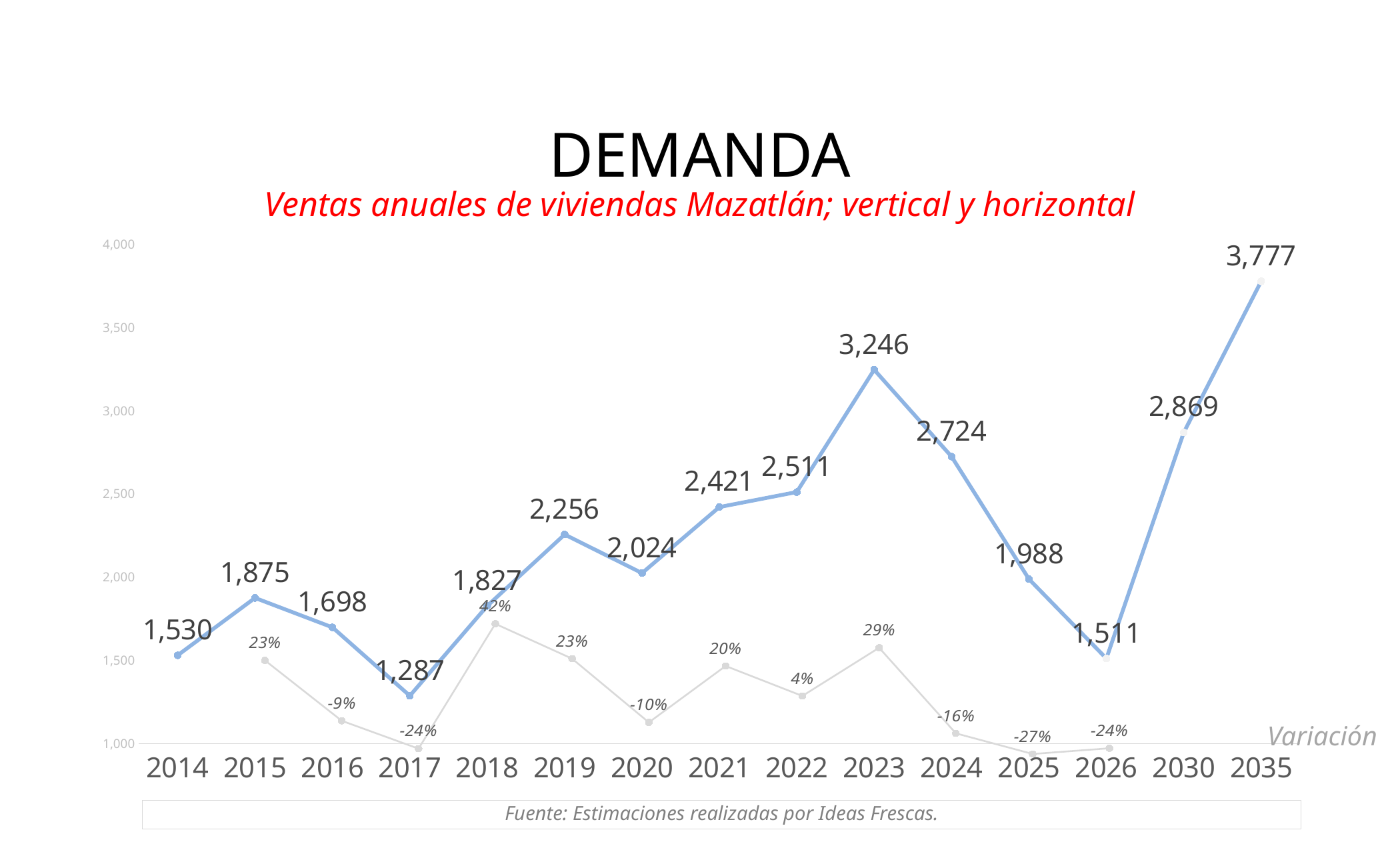
Do the housing sales values rise or fall from 2023 to 2026? Fall How many years are shown on the x axis of the chart? 15 Which year has the lowest annual housing sales value? 2017 What is the 'Variación' percentage shown for 2025? -27% What is the 'Variación' percentage shown for 2018? 42% What type of chart is shown on the slide? Line chart What is the value of annual housing sales for 2014? 1,530 What is the value of annual housing sales for 2035? 3,777 What is the difference between the housing sales values for 2023 and 2024? 522 Which year has the highest annual housing sales value? 2035 Which year has the larger housing sales value, 2019 or 2020? 2019 What is the value of annual housing sales for 2023? 3,246